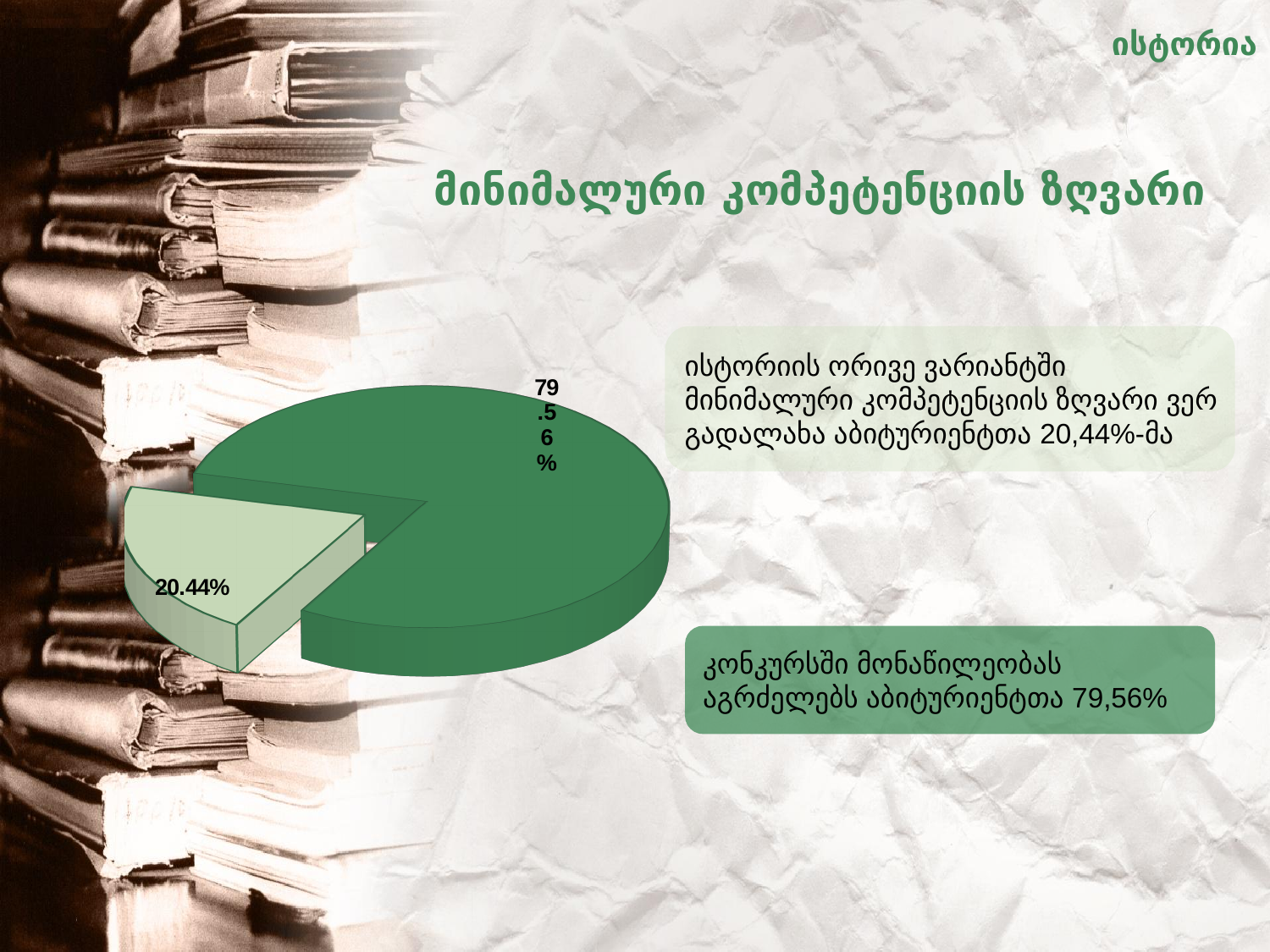
What value is labelled on the large dark green slice of the pie chart? 79.56% What value is labelled on the small light green slice that is pulled out from the pie chart? 20.44% Which slice of the pie chart is the largest, the dark green one or the light green one? the dark green one Is the value of the dark green slice greater or less than 75%? greater Does the pie chart include a legend? No Which slice of the pie chart is the smallest, the dark green one or the light green one? the light green one How many slices does the pie chart have? 2 What is the difference between the two slice values in the pie chart? 59.12% Is the value of the light green slice greater or less than 25%? less Which slice of the pie chart is pulled out (exploded) from the rest of the pie? the light green 20.44% slice What kind of chart is shown on the slide? pie chart What share of the pie does the exploded (pulled-out) slice represent? 20.44%